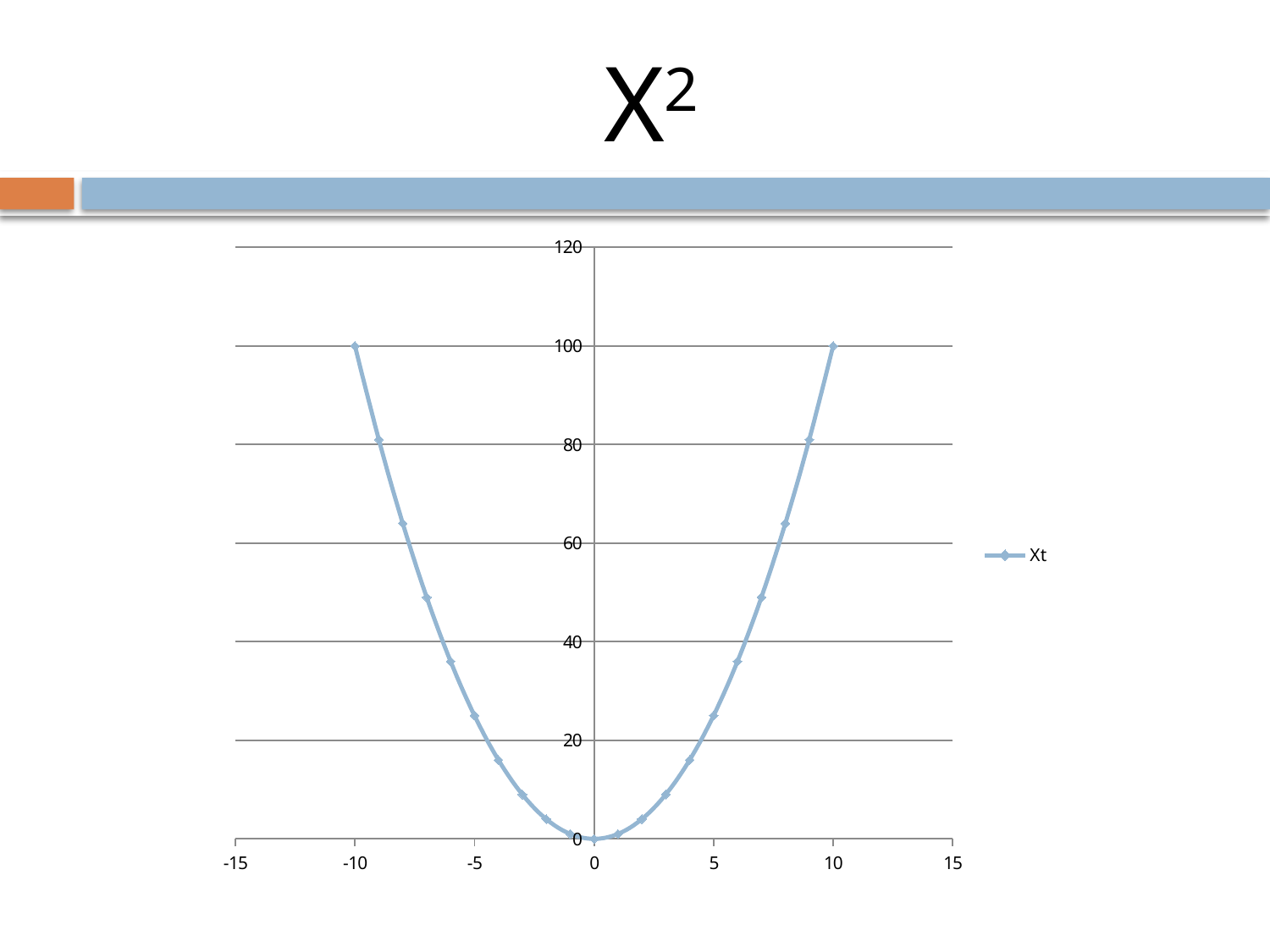
What is the value of Xt at x = 10? 100 How many series does the legend list? 1 What kind of chart is shown on the slide? line chart Do the values of Xt rise or fall as x increases from 0 to 10? rise Is the value of Xt at x = -7 greater or less than 60? less Is the value of Xt at x = 5 greater or less than 20? greater What is the value of Xt at x = 0? 0 At which x value is Xt lowest? 0 What is the value of Xt at x = -10? 100 What is the name of the series shown in the legend? Xt What is the title of the chart? X² What is the highest value of Xt plotted on the chart? 100